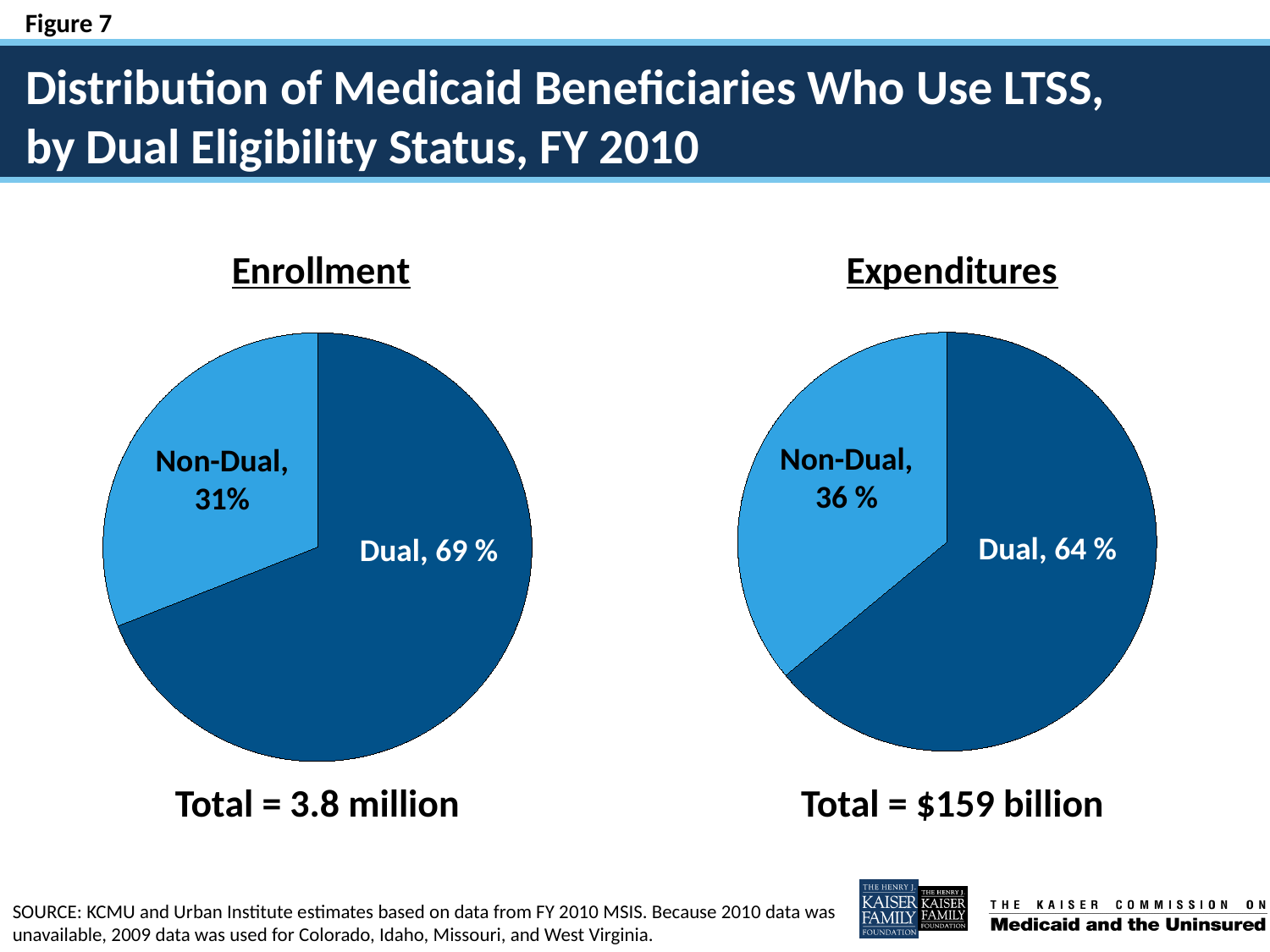
In the Expenditures pie chart, which slice is the smallest? Non-Dual In the Expenditures pie chart, what share is attributed to Non-Dual beneficiaries? 36 % In the Enrollment pie chart, what is the difference in percentage points between the Dual and Non-Dual shares? 38 In the Enrollment pie chart, which slice is the largest? Dual In the Expenditures pie chart, what share is attributed to Dual beneficiaries? 64 % In the Enrollment pie chart, what share do Dual beneficiaries represent? 69 % What total is shown beneath the Expenditures pie chart? Total = $159 billion Is the Non-Dual share larger in the Enrollment pie chart or the Expenditures pie chart? Expenditures In the Enrollment pie chart, what share do Non-Dual beneficiaries represent? 31% What type of chart is used for Expenditures? Pie chart How many slices does the Enrollment pie chart have? 2 In the Expenditures pie chart, what is the difference in percentage points between the Dual and Non-Dual shares? 28